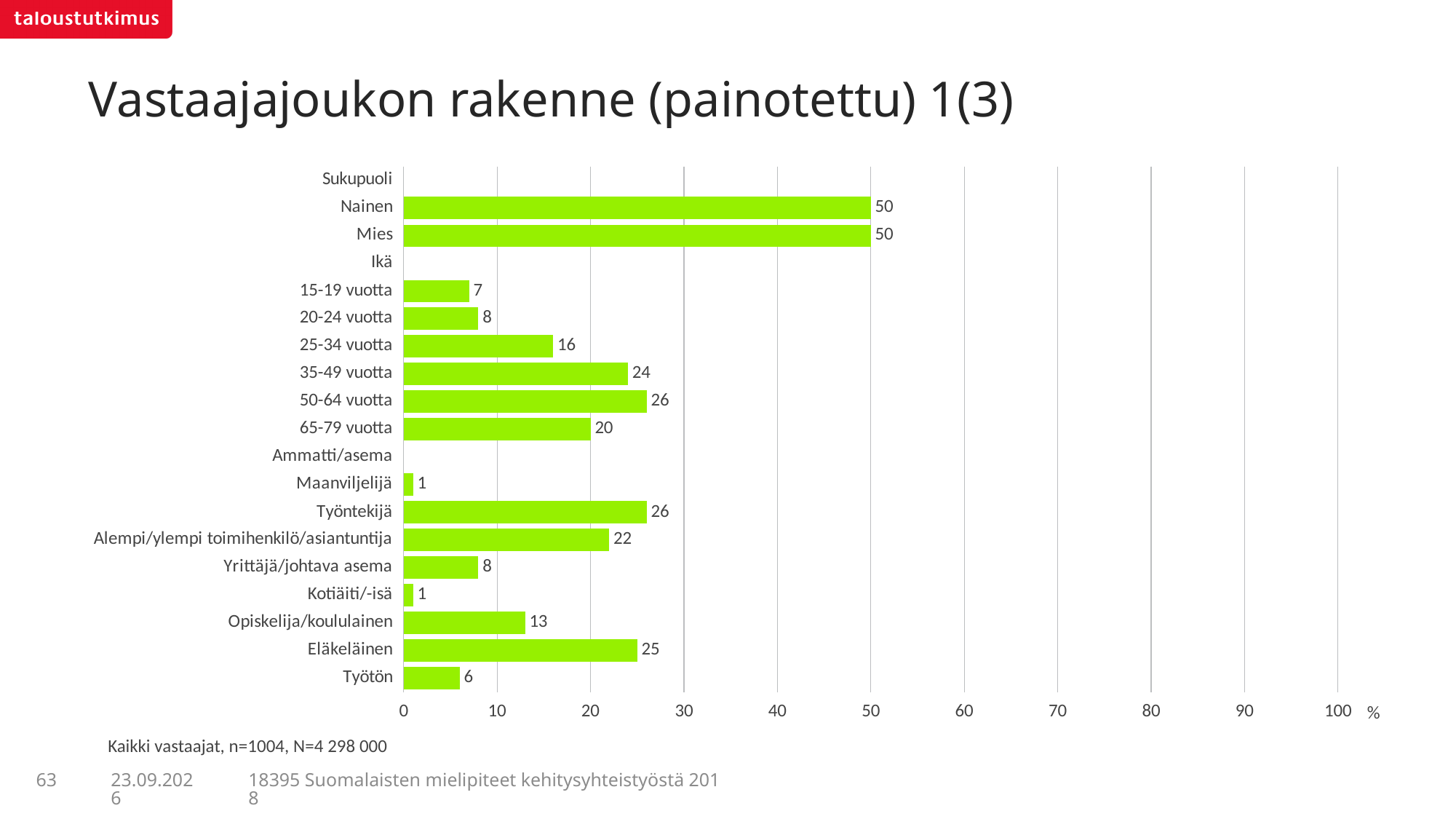
Is the value for 65-79 vuotta greater or less than 30? less Which age group (Ikä) has the highest value? 50-64 vuotta What is the value for Nainen? 50 What is the value for Opiskelija/koululainen? 13 What is the value for 35-49 vuotta? 24 What is the total of the values for Maanviljelijä and Kotiäiti/-isä? 2 Which age group (Ikä) has the lowest value? 15-19 vuotta What is the difference between the values for Eläkeläinen and Työtön? 19 Which is larger, the value for Työntekijä or the value for Eläkeläinen? Työntekijä What is the value for Alempi/ylempi toimihenkilö/asiantuntija? 22 What is the title of the slide? Vastaajajoukon rakenne (painotettu) 1(3) What kind of chart is shown on the slide? bar chart